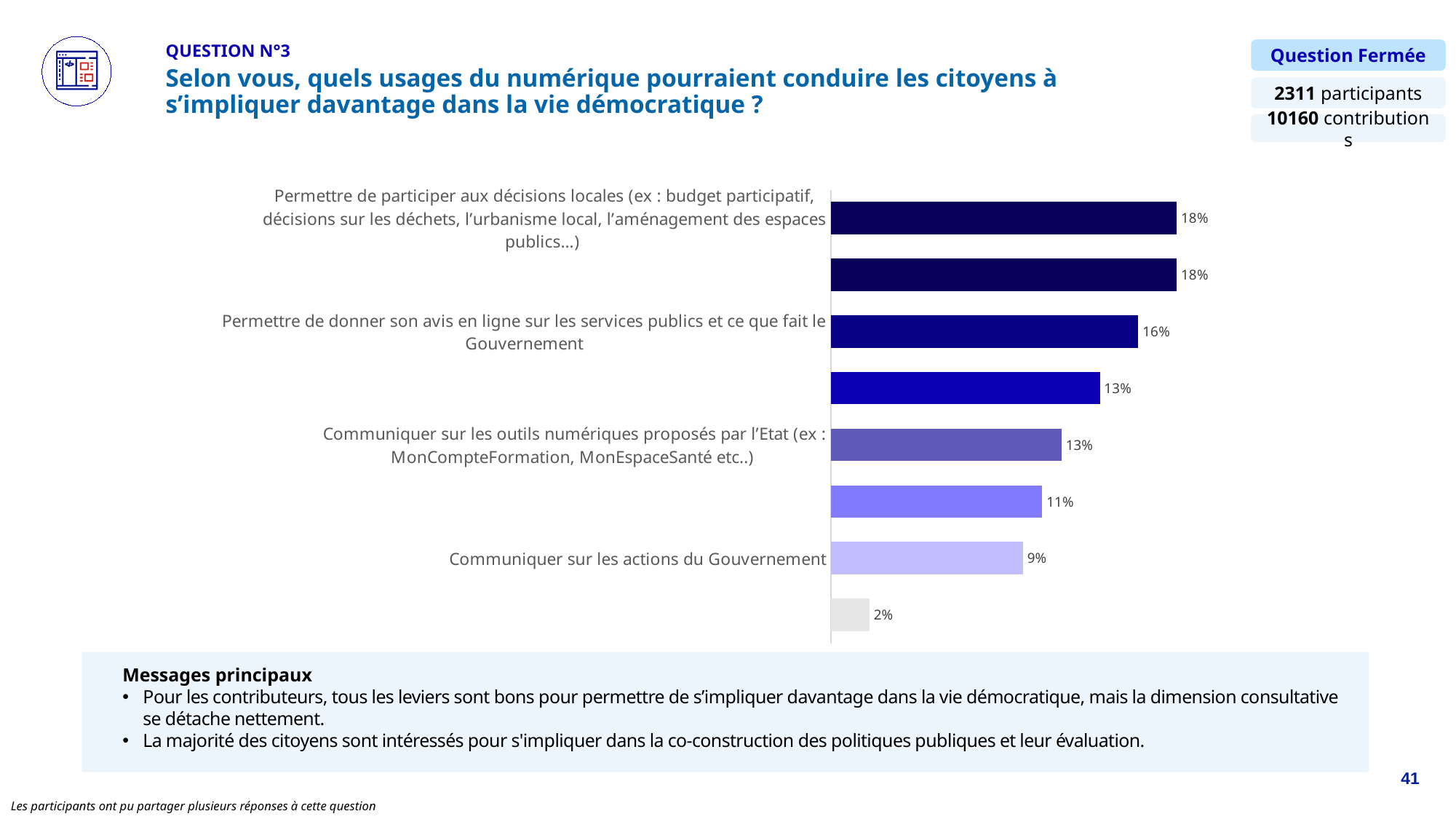
What is the value for "Permettre de participer aux décisions locales (ex : budget participatif, décisions sur les déchets, l'urbanisme local, l'aménagement des espaces publics…)"? 18% What is the value for "Communiquer sur les actions du Gouvernement"? 9% What is the difference between the values for "Permettre de participer aux décisions locales" and "Communiquer sur les outils numériques proposés par l'Etat"? 5% Which is larger: the value for "Communiquer sur les outils numériques proposés par l'Etat" or the value for "Communiquer sur les actions du Gouvernement"? Communiquer sur les outils numériques proposés par l'Etat What is the value for "Communiquer sur les outils numériques proposés par l'Etat (ex : MonCompteFormation, MonEspaceSanté etc..)"? 13% Do the bar values increase or decrease from the top of the chart to the bottom? decrease What is the lowest value shown in the chart? 2% How many bars are plotted in the chart? 8 What is the difference between the values for "Permettre de donner son avis en ligne sur les services publics et ce que fait le Gouvernement" and "Communiquer sur les actions du Gouvernement"? 7% What is the highest value shown in the chart? 18% What is the value for "Permettre de donner son avis en ligne sur les services publics et ce que fait le Gouvernement"? 16% What kind of chart is shown on the slide? bar chart